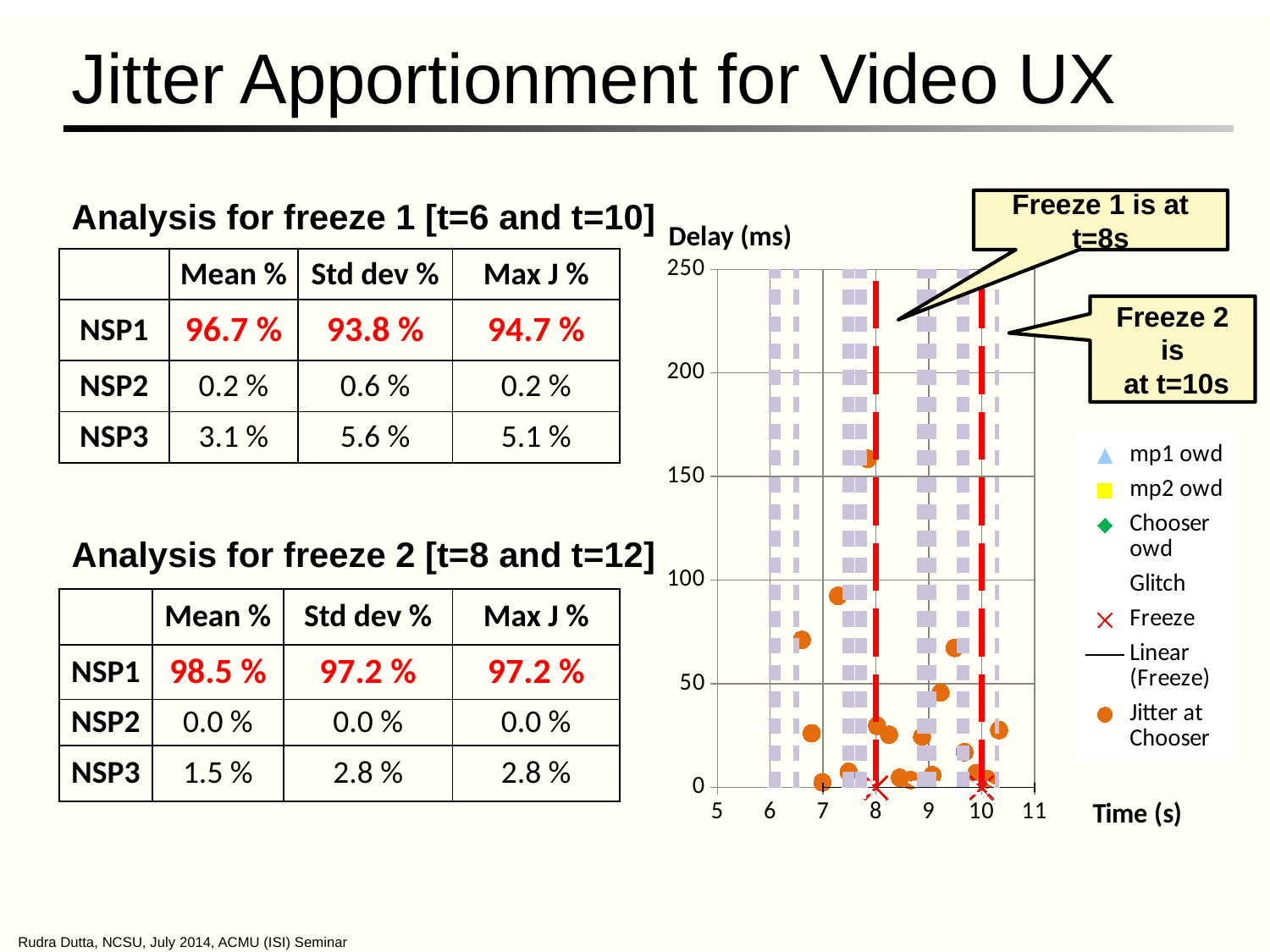
According to the callout on the chart, at what time does Freeze 1 occur? t=8s What kind of chart is shown on the right of the slide? scatter chart According to the callout on the chart, at what time does Freeze 2 occur? t=10s What is the label of the horizontal axis of the chart? Time (s) What is the label of the vertical axis of the chart? Delay (ms) Which of the two freeze events marked on the chart occurs later in time, Freeze 1 or Freeze 2? Freeze 2 How many series does the legend of the chart list? 7